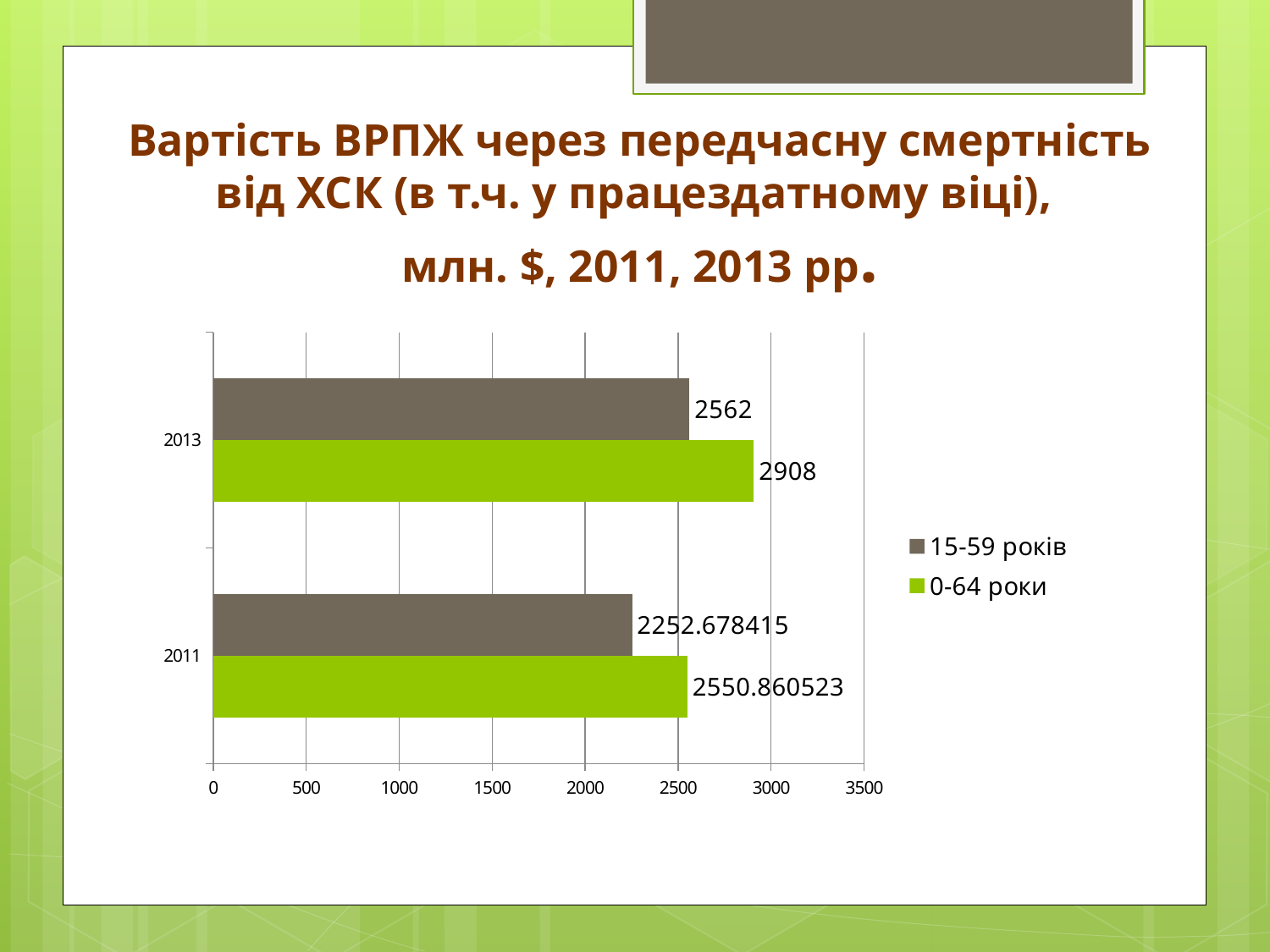
Does the value for 15-59 років rise or fall from 2011 to 2013? rise What is the value for 15-59 років in 2013? 2562 What is the value for 0-64 роки in 2011? 2550.860523 Which is larger in 2011: the value for 0-64 роки or for 15-59 років? 0-64 роки What is the difference between the 0-64 роки and 15-59 років values in 2013? 346 Which year has the higher value for 0-64 роки? 2013 Which year has the lower value for 15-59 років? 2011 What kind of chart is shown on the slide? bar chart What is the value for 15-59 років in 2011? 2252.678415 Is the value for 15-59 років in 2011 greater or less than 2500? less How many series does the legend list? 2 What is the value for 0-64 роки in 2013? 2908